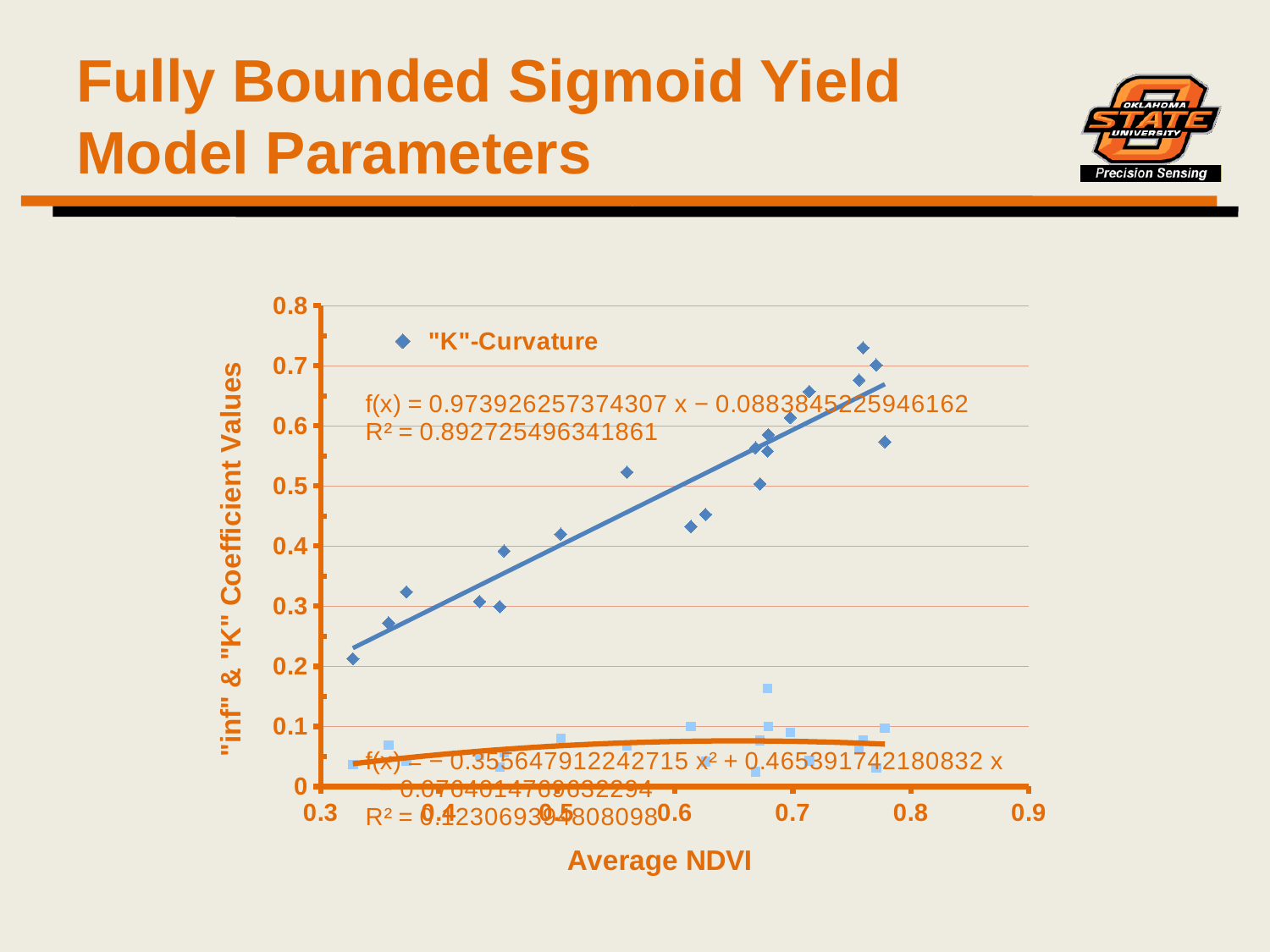
What kind of chart is shown on the slide? Scatter chart How many series does the chart legend list? 1 Is the highest "K"-Curvature value on the chart greater or less than 0.7? greater Do the "K"-Curvature values rise or fall as Average NDVI increases? Rise What is the highest value shown on the y axis? 0.8 Is the "K"-Curvature value at the lowest Average NDVI (about 0.33) greater or less than 0.3? less What is the title of the x axis? Average NDVI What is the R² value printed for the linear trend line of the "K"-Curvature series? R² = 0.892725496341861 At an Average NDVI of about 0.6, which is larger: the "K"-Curvature diamond marker or the light blue square marker? The "K"-Curvature diamond marker Is the "K"-Curvature value at an Average NDVI of about 0.56 greater or less than 0.5? greater What is the slope of the linear trend line equation f(x) = 0.973926257374307 x − 0.0883845225946162? 0.973926257374307 What is the name of the series shown in the chart legend? "K"-Curvature